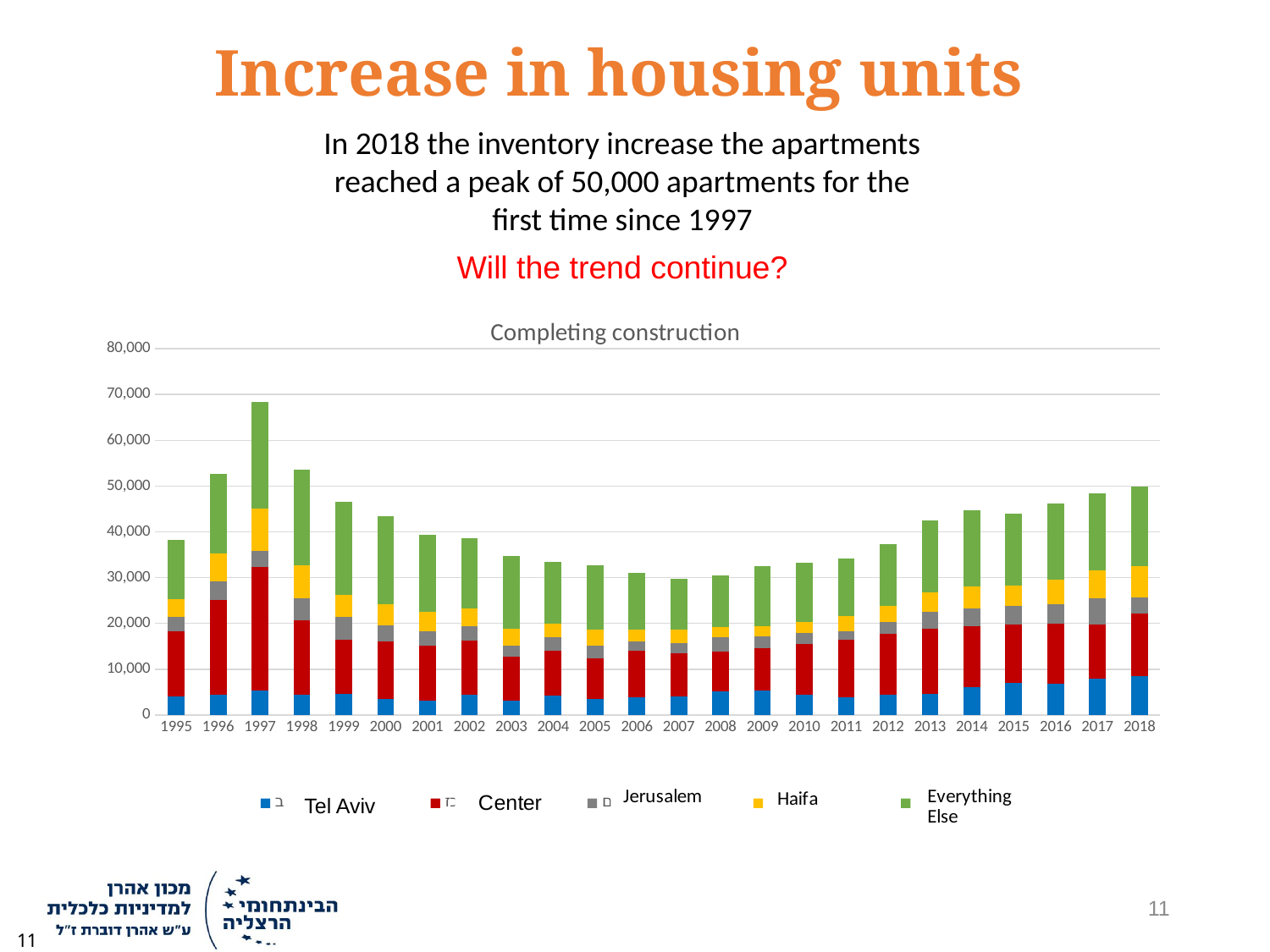
Is the total for 2018 greater or less than 40,000? greater What kind of chart is shown on the slide? Stacked bar chart Which year has a larger total, 1996 or 1999? 1996 Do the totals generally rise or fall from 2007 to 2018? rise How many years are shown along the x axis of the chart? 24 Is the total for 1995 greater or less than 40,000? less Which series is shown in green in the chart? Everything Else Is the total for 1997 greater or less than 60,000? greater How many series does the chart's legend list? 5 What is the title of the chart? Completing construction Which year has the highest total of completed construction in the chart? 1997 Which year has the lowest total of completed construction in the chart? 2007